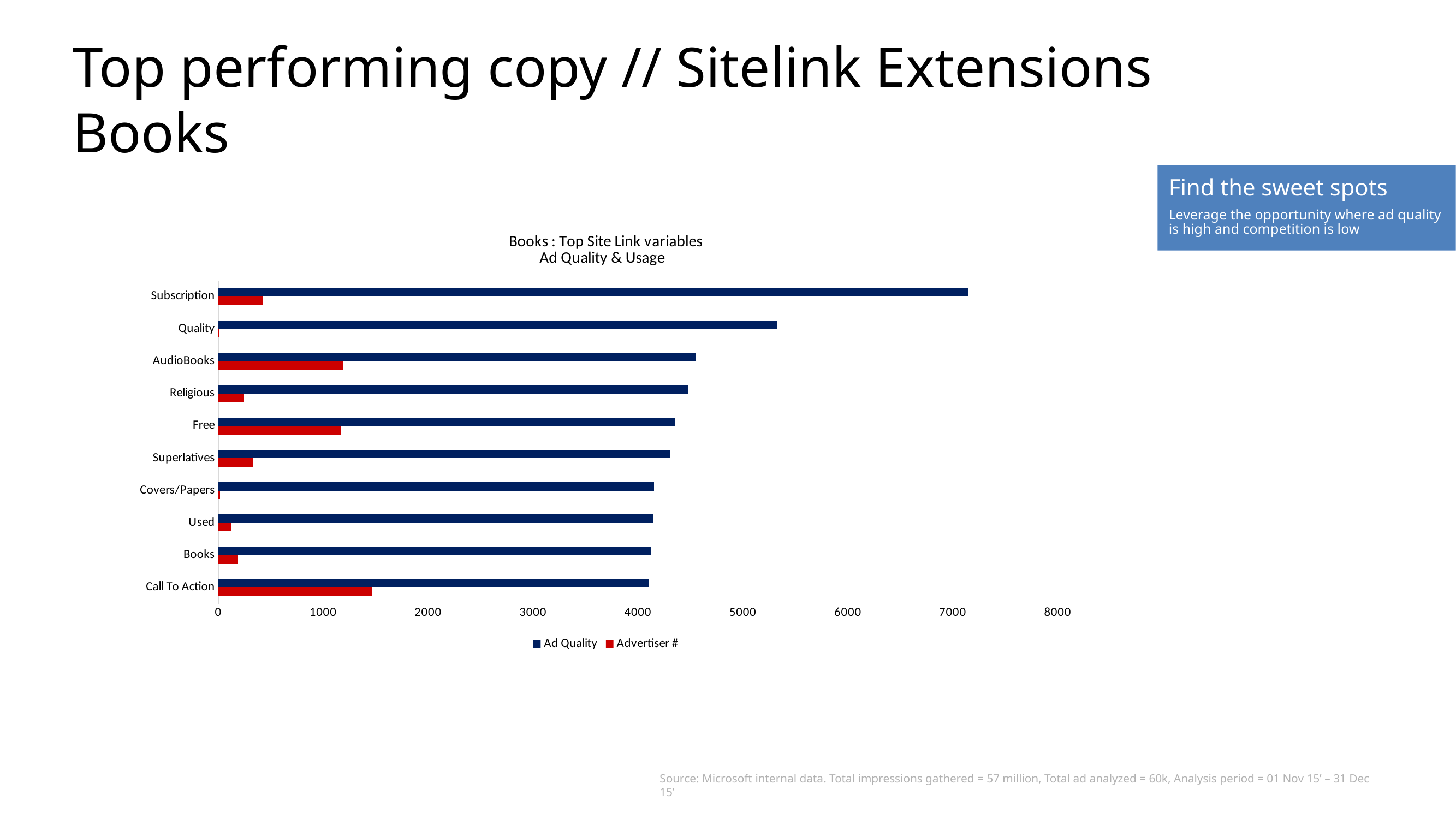
Which has the larger Ad Quality value, Subscription or Quality? Subscription How many series does the chart legend list? 2 Is the Advertiser # value for Call To Action greater or less than 1000? greater What is the title of the chart? Books : Top Site Link variables Ad Quality & Usage Is the Ad Quality value for Subscription greater or less than 7000? greater Is the Ad Quality value for Quality greater or less than 5000? greater What kind of chart is shown on the slide? Bar chart How many categories are plotted on the chart? 10 Which category has the highest Ad Quality value? Subscription Which category has the highest Advertiser # value? Call To Action